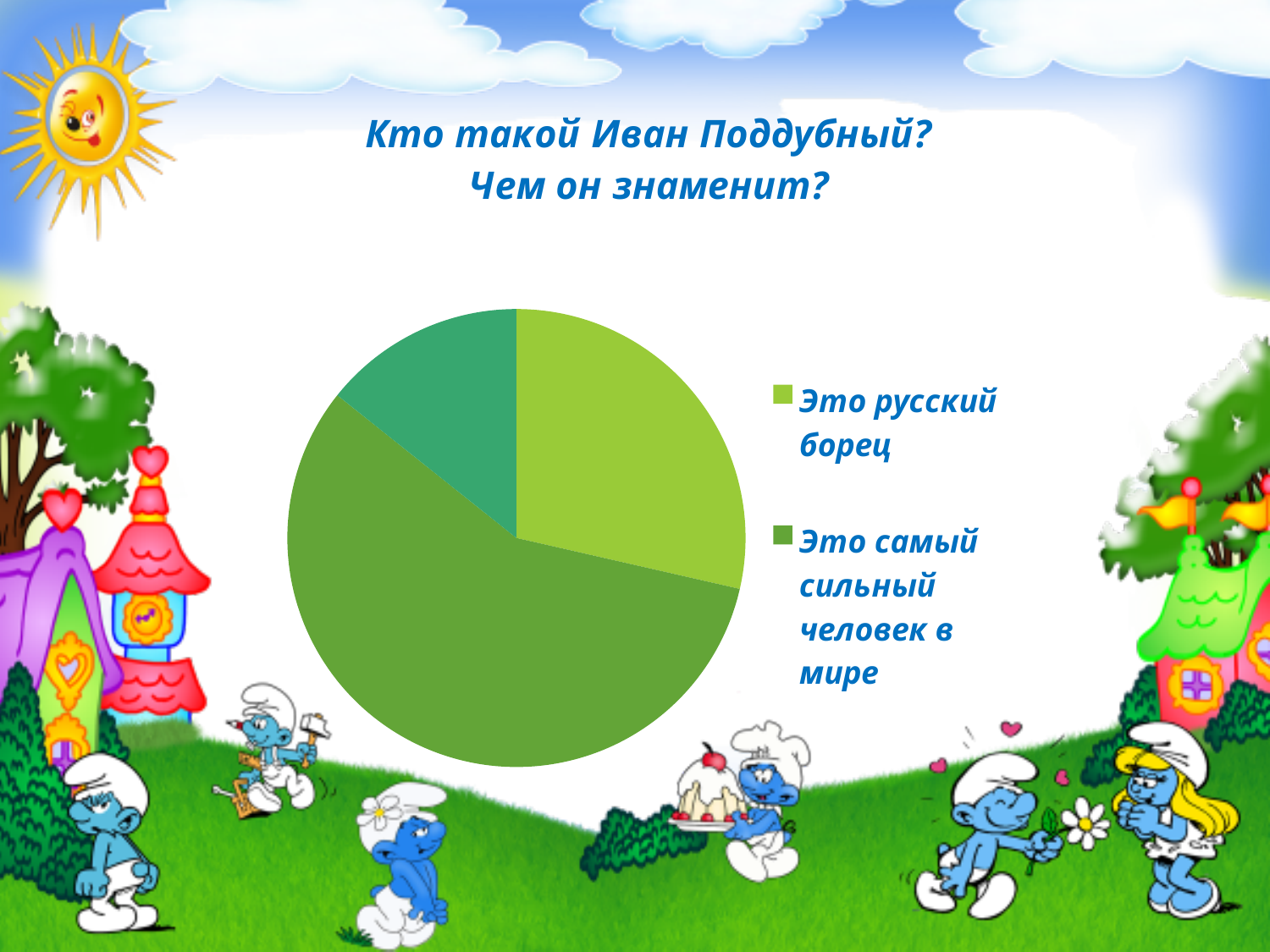
Which slice is larger: "Это русский борец" or "Это самый сильный человек в мире"? Это самый сильный человек в мире What kind of chart is shown on the slide? pie chart Which legend category has the largest slice of the pie? Это самый сильный человек в мире How many slices does the pie chart have? 3 How many entries does the chart's legend list? 2 What is the title text above the chart? Кто такой Иван Поддубный? Чем он знаменит? What is the first entry listed in the chart's legend? Это русский борец